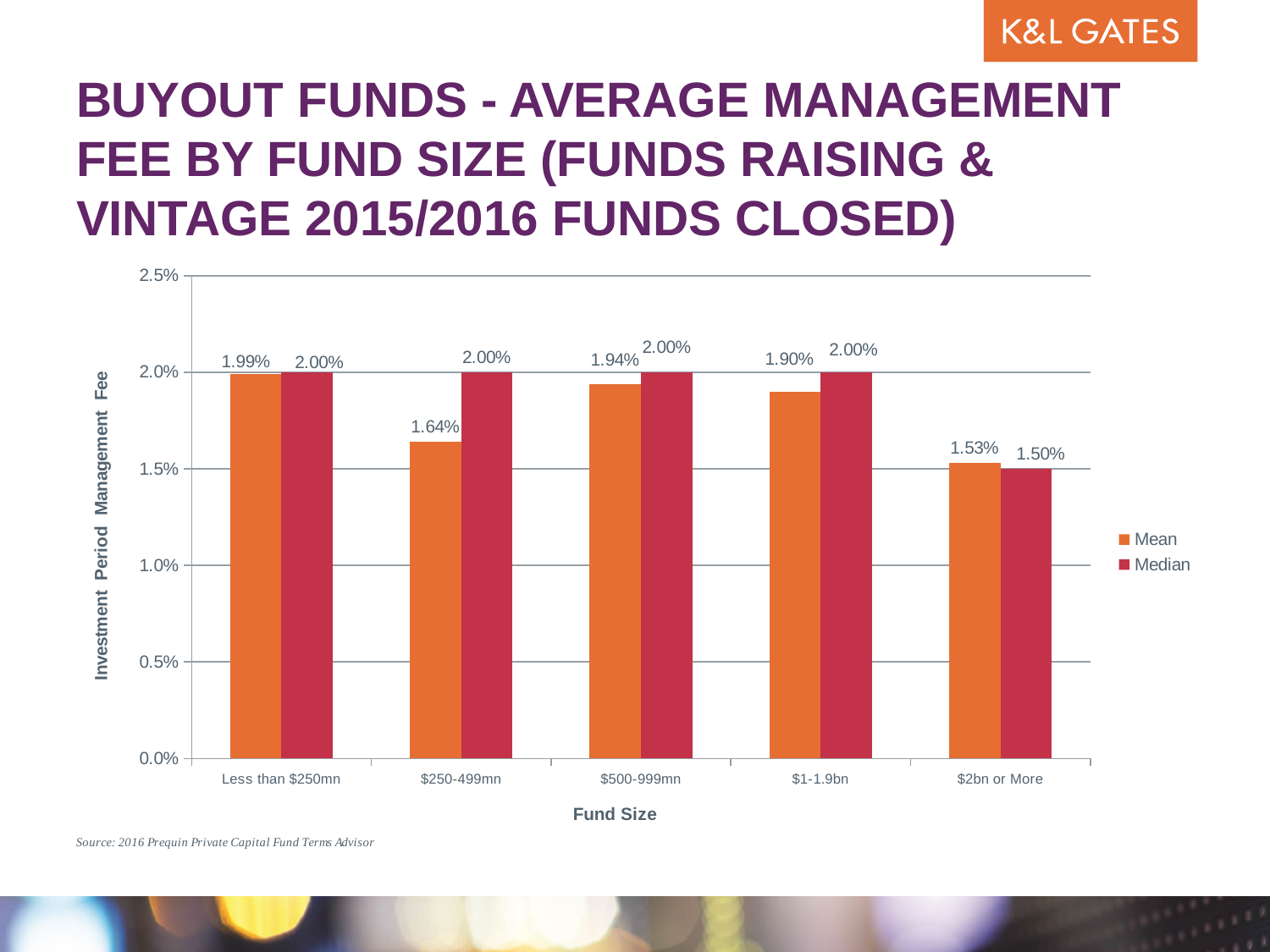
What is the Mean investment period management fee for funds of $250-499mn? 1.64% What is the Mean management fee for funds of $1-1.9bn? 1.90% How many series does the legend list? 2 What is the label of the x axis? Fund Size Which fund size has the highest Mean management fee? Less than $250mn What is the difference between the Mean management fee for Less than $250mn funds and for $2bn or More funds? 0.46% How many fund size categories are shown on the x axis? 5 What kind of chart is shown on the slide? Bar chart What is the Median investment period management fee for funds of $2bn or More? 1.50% For funds of $2bn or More, which is larger, the Mean or the Median management fee? Mean Which fund size has the lowest Mean management fee? $2bn or More Is the Mean management fee for $500-999mn funds greater or less than 1.5%? greater